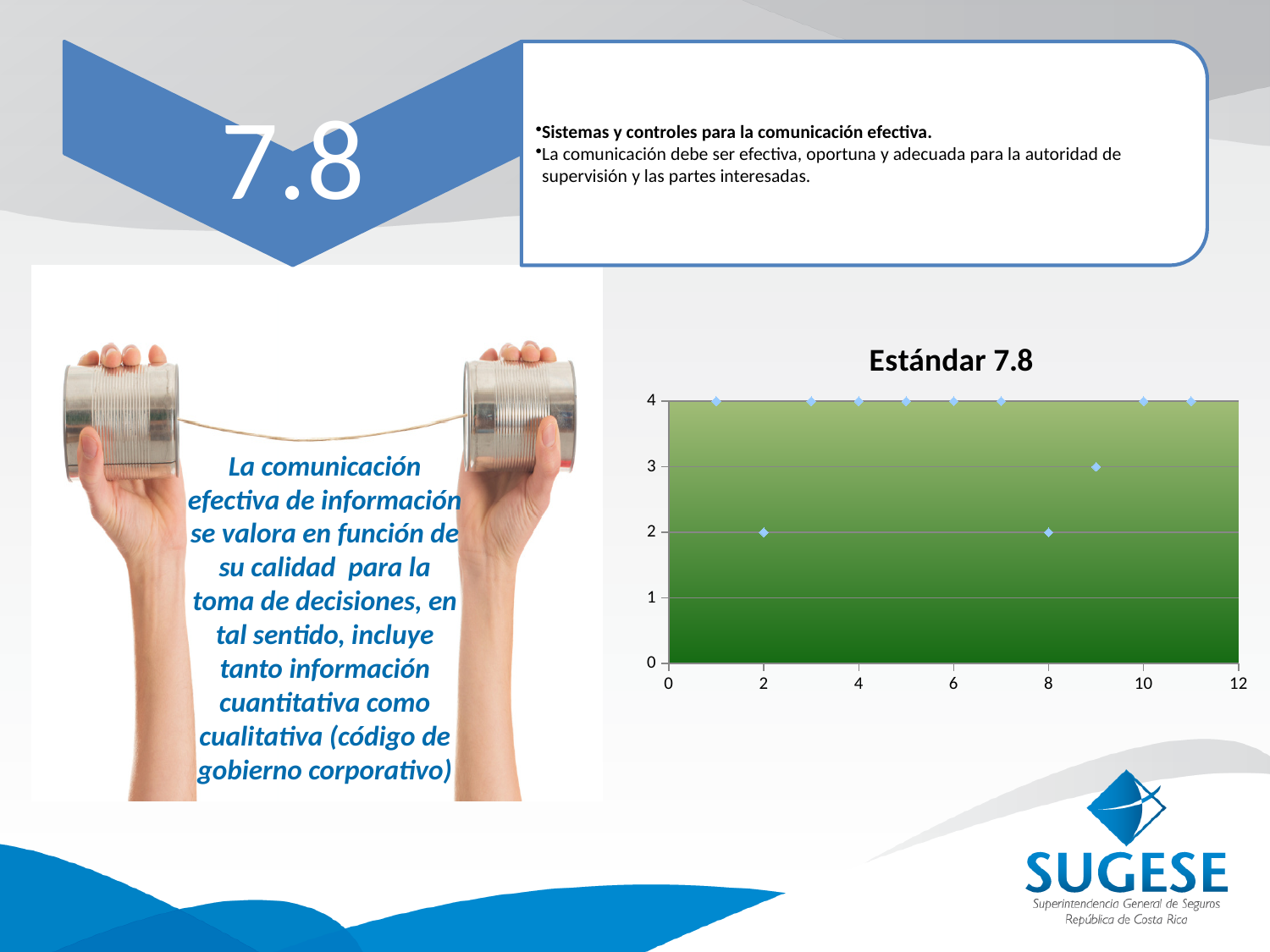
What kind of chart is shown under the title "Estándar 7.8"? scatter chart In the "Estándar 7.8" chart, which point has the larger y value: the one at x = 8 or the one at x = 10? x = 10 What is the maximum value shown on the y axis of the "Estándar 7.8" chart? 4 In the "Estándar 7.8" chart, what is the y value of the point at x = 2? 2 In the "Estándar 7.8" chart, what is the highest y value reached by any point? 4 What is the title of the chart on the slide? Estándar 7.8 How many data points are plotted in the "Estándar 7.8" chart? 11 In the "Estándar 7.8" chart, what is the y value of the point at x = 8? 2 In the "Estándar 7.8" chart, what is the y value of the point at x = 10? 4 In the "Estándar 7.8" chart, is the y value of the point at x = 2 greater or less than 3? less In the "Estándar 7.8" chart, what is the lowest y value reached by any point? 2 In the "Estándar 7.8" chart, what is the difference between the y value at x = 10 and the y value at x = 8? 2